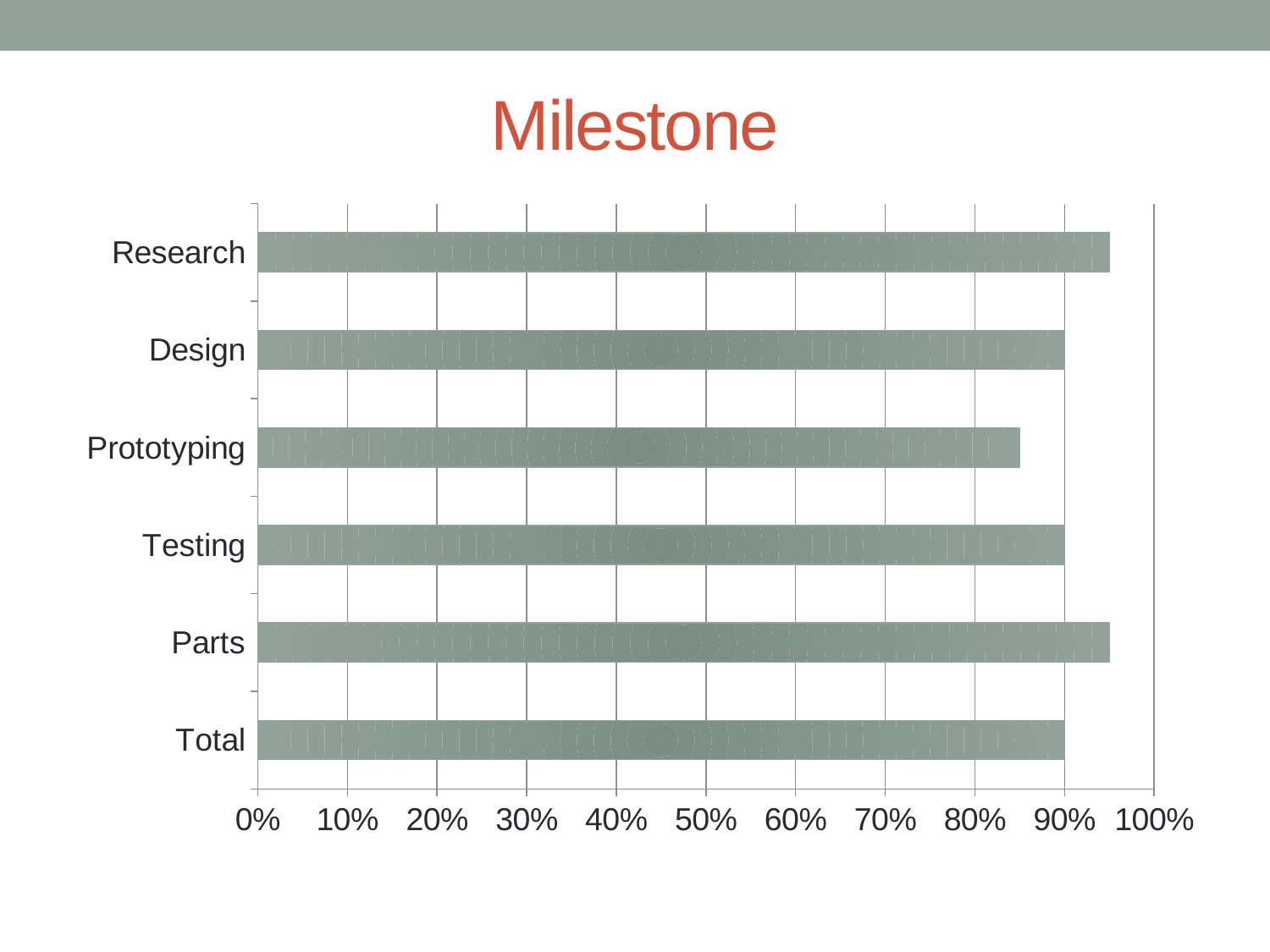
What is the value for Design? 90% What is the value for Testing? 90% Is the value for Prototyping greater or less than 90%? less What is the value for Total? 90% What type of chart is shown on the slide? bar chart Is the value for Research greater or less than 90%? greater How many categories are shown in the chart? 6 Which is larger, the value for Research or the value for Design? Research Which category has the lowest value? Prototyping Is the value for Parts greater or less than 90%? greater Which is larger, the value for Prototyping or the value for Testing? Testing What is the title of the chart? Milestone